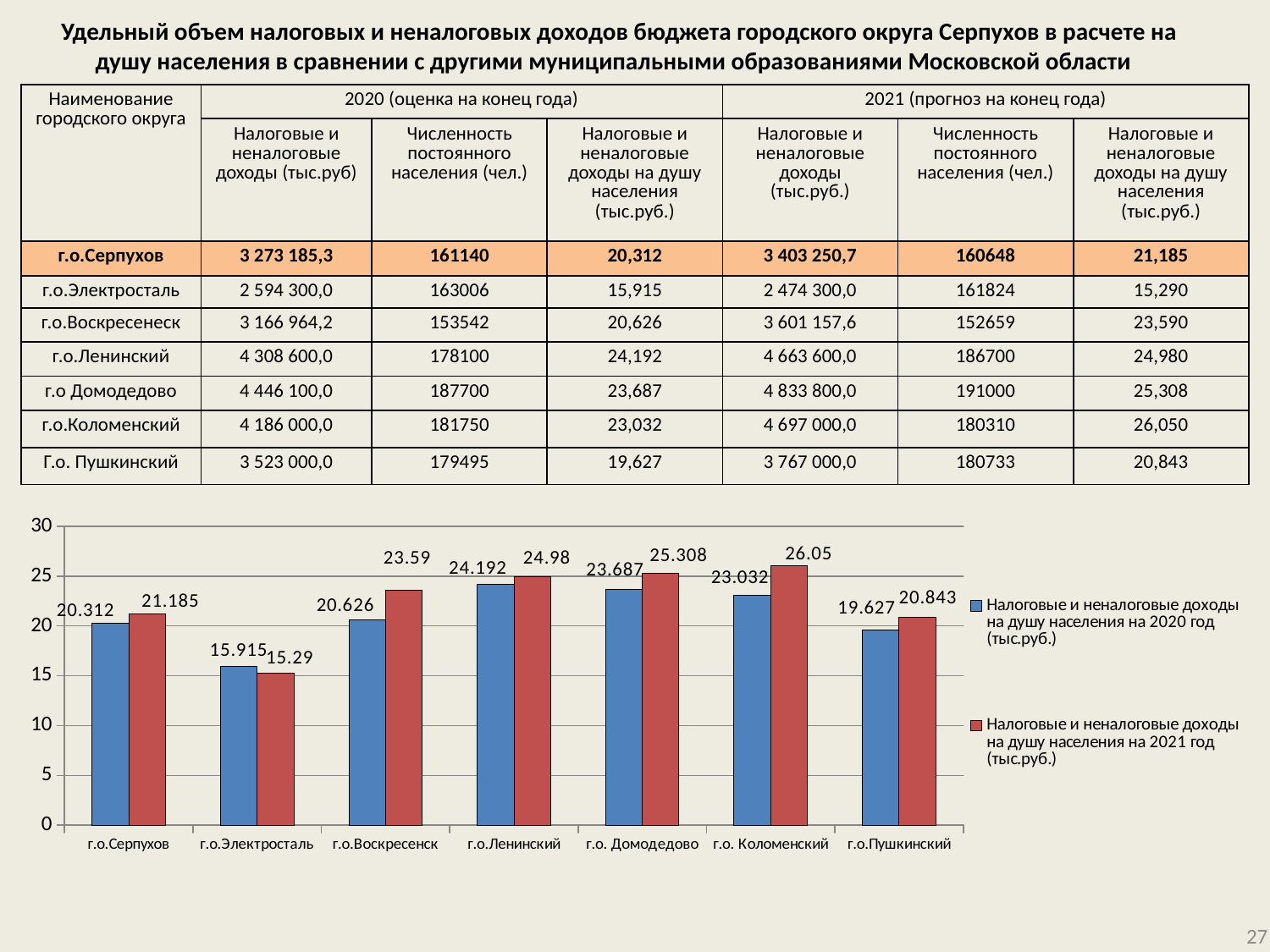
What type of chart is shown on the slide? bar chart What is the value for г.о.Электросталь in the 2021 series? 15.29 How many series does the chart legend list? 2 Which category has the lowest value in the 2020 series? г.о.Электросталь What is the value for г.о. Коломенский in the 2021 series? 26.05 Which category has the highest value in the 2021 series? г.о. Коломенский What is the value for г.о.Серпухов in the 2020 series (Налоговые и неналоговые доходы на душу населения на 2020 год)? 20.312 How many categories (municipalities) are shown on the x axis of the chart? 7 What is the difference between the 2021 and 2020 values for г.о. Коломенский? 3.018 Which category has the highest value in the 2020 series? г.о.Ленинский Is the 2021 value for г.о.Пушкинский greater or less than 25? less Which is larger for г.о.Электросталь: the 2020 value or the 2021 value? the 2020 value (15.915)